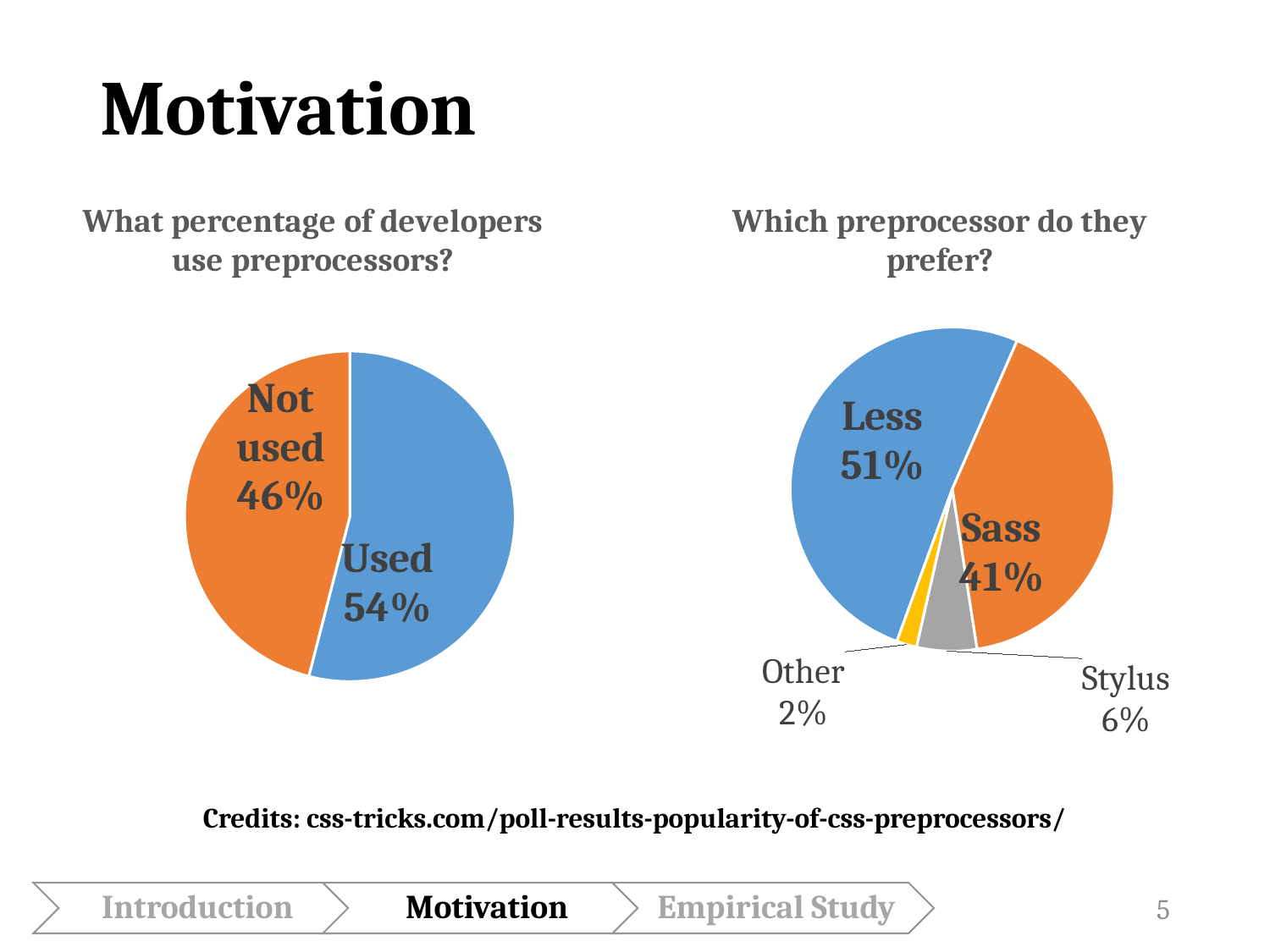
In the chart titled "Which preprocessor do they prefer?", what is the value for "Less"? 51% In the chart titled "Which preprocessor do they prefer?", how many slices does the pie have? 4 In the chart titled "What percentage of developers use preprocessors?", what is the difference between "Used" and "Not used"? 8% In the chart titled "Which preprocessor do they prefer?", which preprocessor has the largest share? Less In the chart titled "Which preprocessor do they prefer?", which category has the smallest share? Other In the chart titled "Which preprocessor do they prefer?", what is the difference between "Less" and "Sass"? 10% In the chart titled "Which preprocessor do they prefer?", what is the value for "Stylus"? 6% In the chart titled "What percentage of developers use preprocessors?", what is the value for "Used"? 54% In the chart titled "Which preprocessor do they prefer?", what colour is the "Other" slice? Yellow In the chart titled "What percentage of developers use preprocessors?", what kind of chart is shown? Pie chart In the chart titled "Which preprocessor do they prefer?", which is larger, "Sass" or "Stylus"? Sass In the chart titled "What percentage of developers use preprocessors?", what is the value for "Not used"? 46%